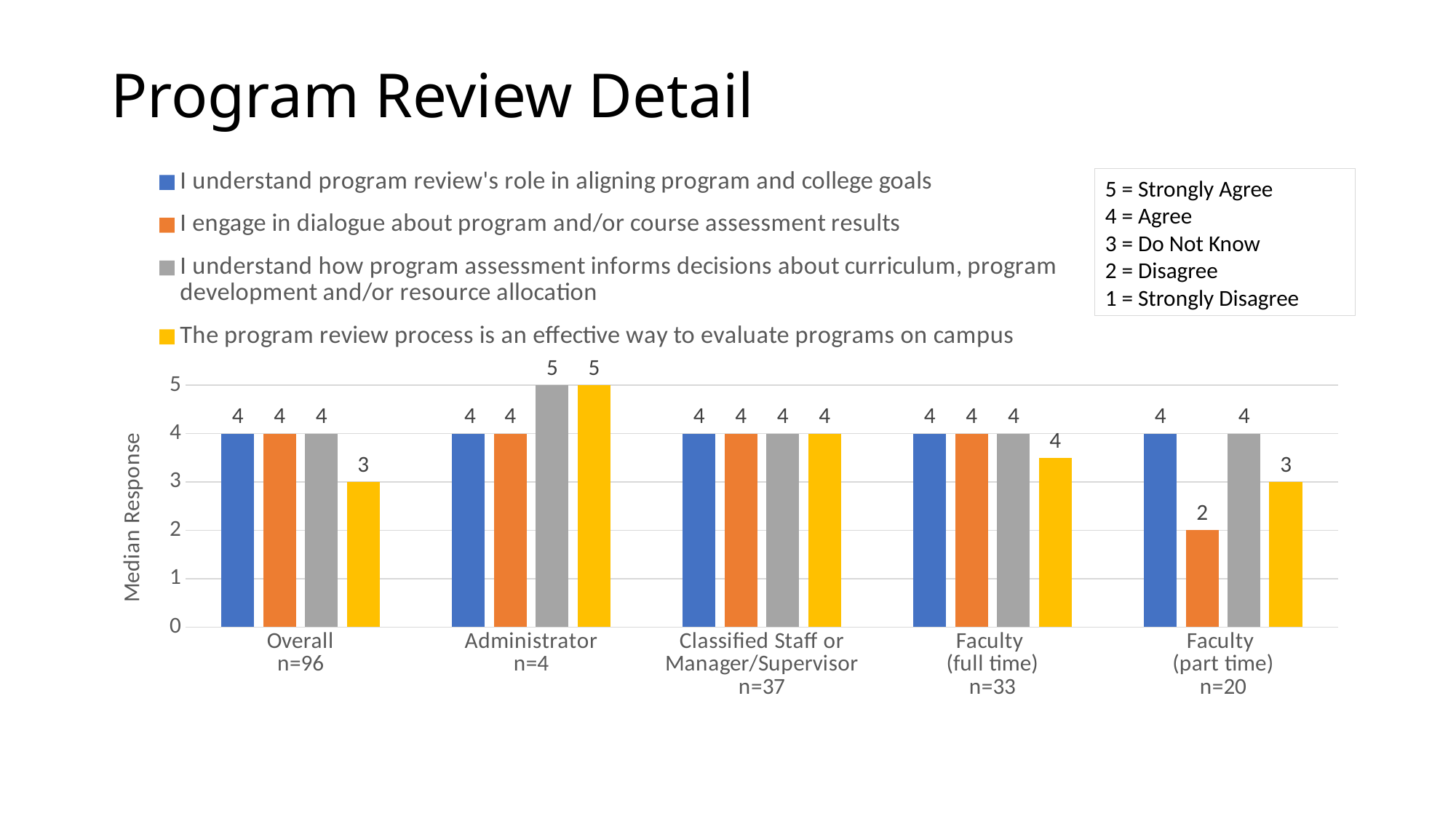
For Faculty (part time), which is larger: the median response for 'I understand program review's role in aligning program and college goals' or for 'I engage in dialogue about program and/or course assessment results'? I understand program review's role in aligning program and college goals What is the difference between the Administrator and Faculty (part time) median responses for 'The program review process is an effective way to evaluate programs on campus'? 2 How many series does the legend list? 4 What is the label of the y axis? Median Response Which respondent group has the lowest median response for 'I engage in dialogue about program and/or course assessment results'? Faculty (part time) What is the median response for 'I understand how program assessment informs decisions about curriculum, program development and/or resource allocation' among Administrators? 5 Which respondent group has the highest median response for 'The program review process is an effective way to evaluate programs on campus'? Administrator What kind of chart is shown on the slide? bar chart What is the median response for 'The program review process is an effective way to evaluate programs on campus' in the Overall group? 3 What is the sample size (n) shown for the Classified Staff or Manager/Supervisor group? n=37 What is the median response for 'I engage in dialogue about program and/or course assessment results' among Faculty (part time)? 2 How many respondent groups (categories) are shown on the x axis? 5